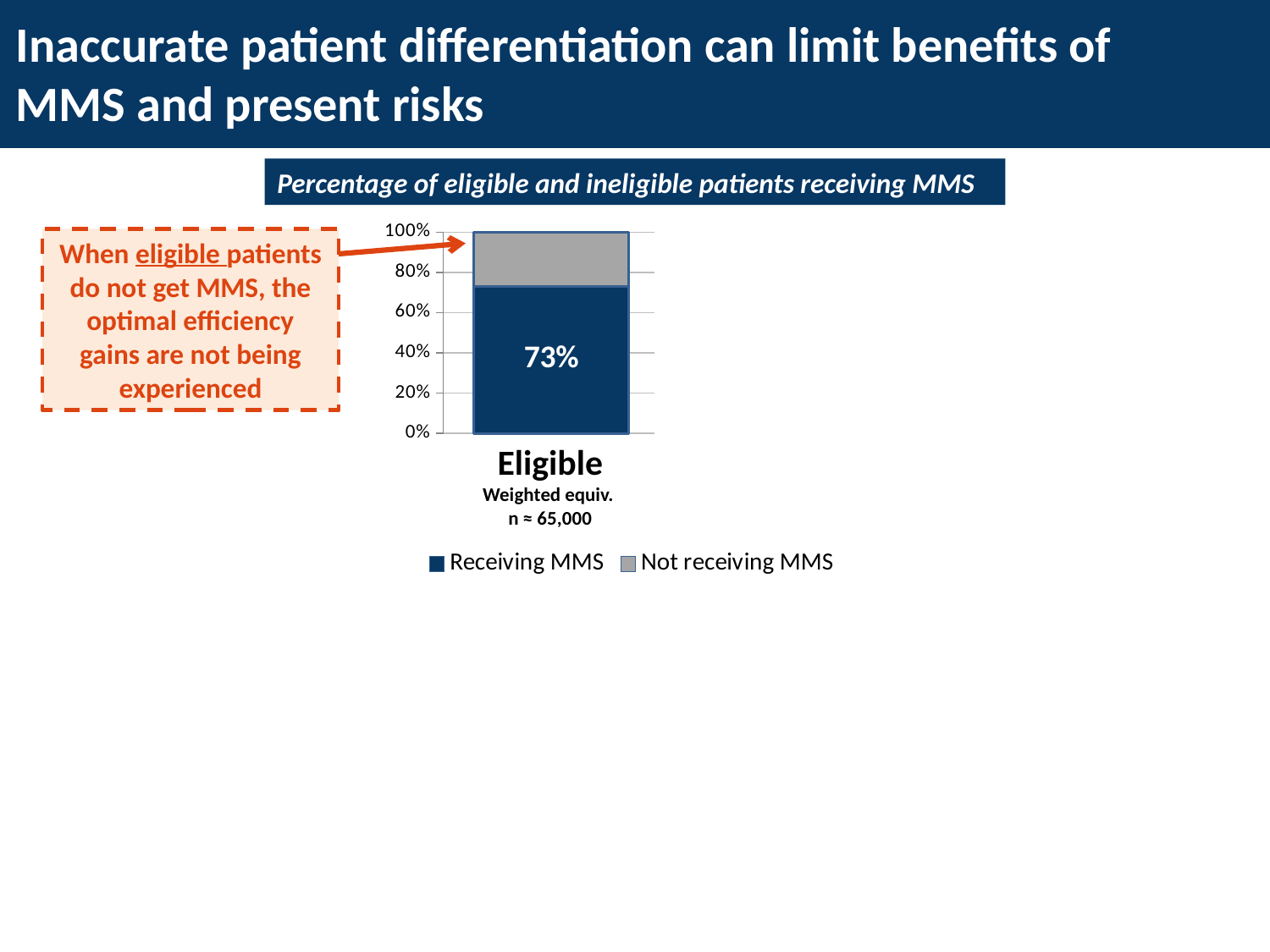
Which segment of the Eligible bar is larger, Receiving MMS or Not receiving MMS? Receiving MMS What is the title of the chart? Percentage of eligible and ineligible patients receiving MMS How many categories are plotted on the x axis of the chart? 1 How many series does the chart legend list? 2 Is the value for Receiving MMS in the Eligible bar greater or less than 60%? greater Which series is shown in dark blue in the chart? Receiving MMS What percentage of eligible patients are receiving MMS? 73% What is the weighted equivalent sample size shown under the Eligible bar? n ≈ 65,000 What is the category label on the x axis of the chart? Eligible What kind of chart is shown on the slide? Stacked bar chart What is the highest value shown on the y axis of the chart? 100% Is the Not receiving MMS segment of the Eligible bar greater or less than 40%? less